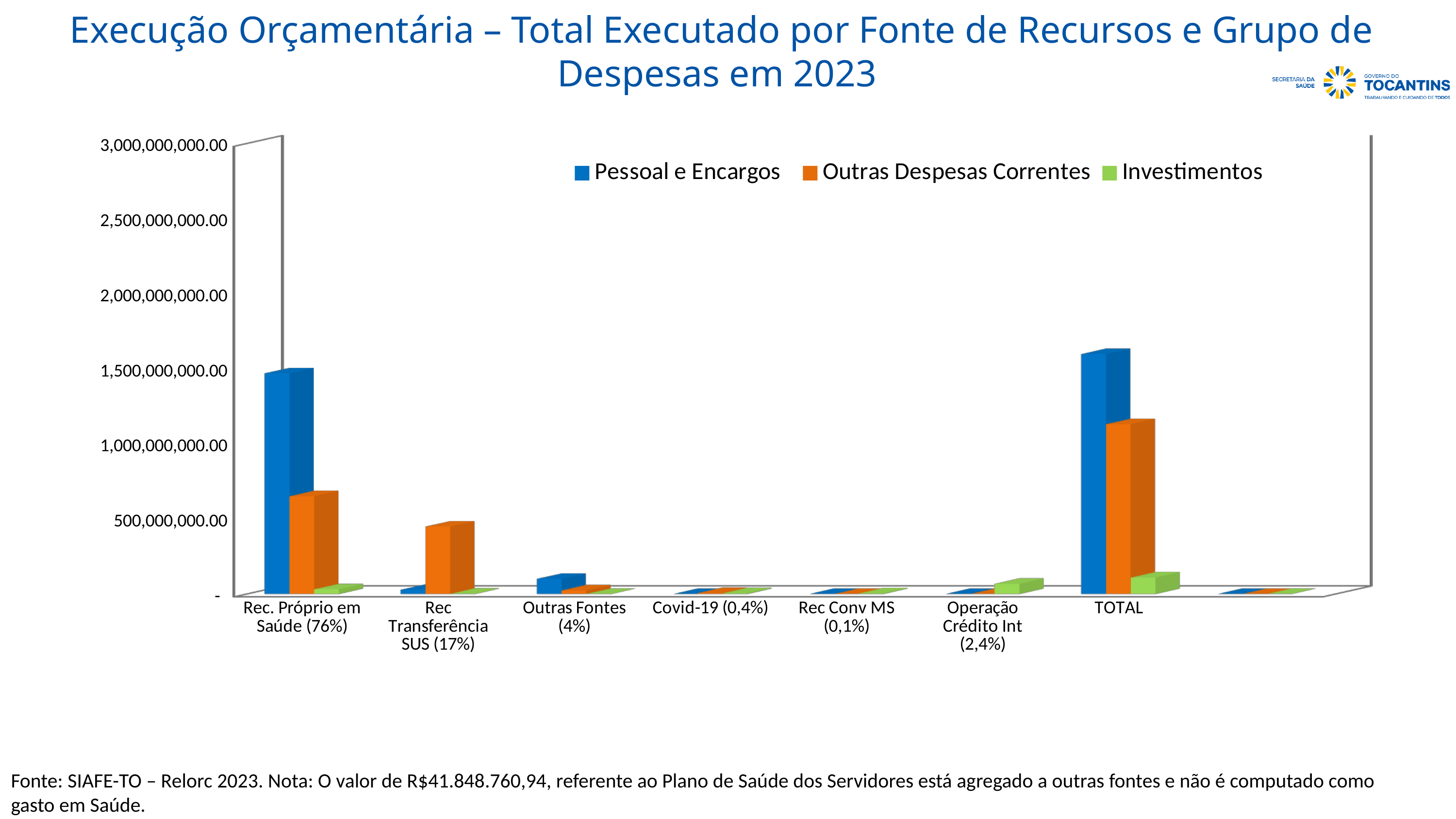
How many categories are shown along the x axis? 7 Excluding TOTAL, which category has the tallest Pessoal e Encargos bar? Rec. Próprio em Saúde (76%) What kind of chart is shown on the slide? bar chart Is the Pessoal e Encargos value for Rec. Próprio em Saúde (76%) greater or less than 1,000,000,000.00? greater For Rec. Próprio em Saúde (76%), which is larger: Pessoal e Encargos or Outras Despesas Correntes? Pessoal e Encargos How many series does the legend list? 3 Excluding TOTAL, which category has the tallest Investimentos bar? Operação Crédito Int (2,4%) Which category has the tallest Pessoal e Encargos bar? TOTAL For Rec Transferência SUS (17%), which is larger: Pessoal e Encargos or Outras Despesas Correntes? Outras Despesas Correntes Is the Outras Despesas Correntes value for Rec. Próprio em Saúde (76%) greater or less than 500,000,000.00? greater What colour represents the Investimentos series in the legend? green Is the Outras Despesas Correntes value for TOTAL greater or less than 1,500,000,000.00? less